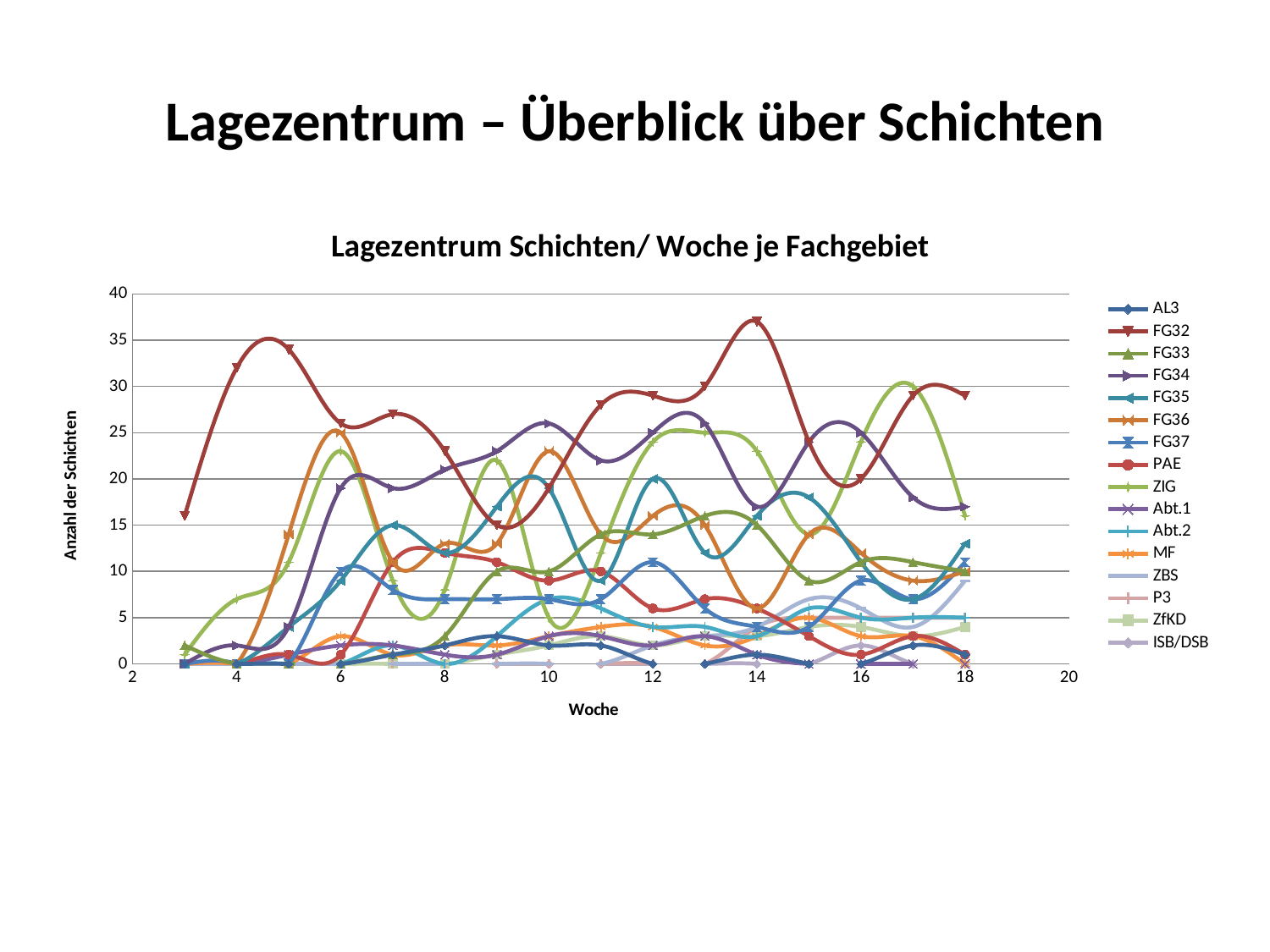
Does the FG32 line rise or fall from week 14 to week 15? fall In which week does FG32 reach its highest value? 14 What is the label of the vertical axis? Anzahl der Schichten Is the value for FG32 in week 4 greater or less than 30? greater Which series reaches the highest value on the chart? FG32 Is the value for FG36 in week 10 greater or less than 20? greater In week 14, which is larger, FG32 or FG34? FG32 What is the title of the chart? Lagezentrum Schichten/ Woche je Fachgebiet How many series does the legend list? 16 What kind of chart is shown on the slide? line chart Is the value for ZIG in week 18 greater or less than 20? less